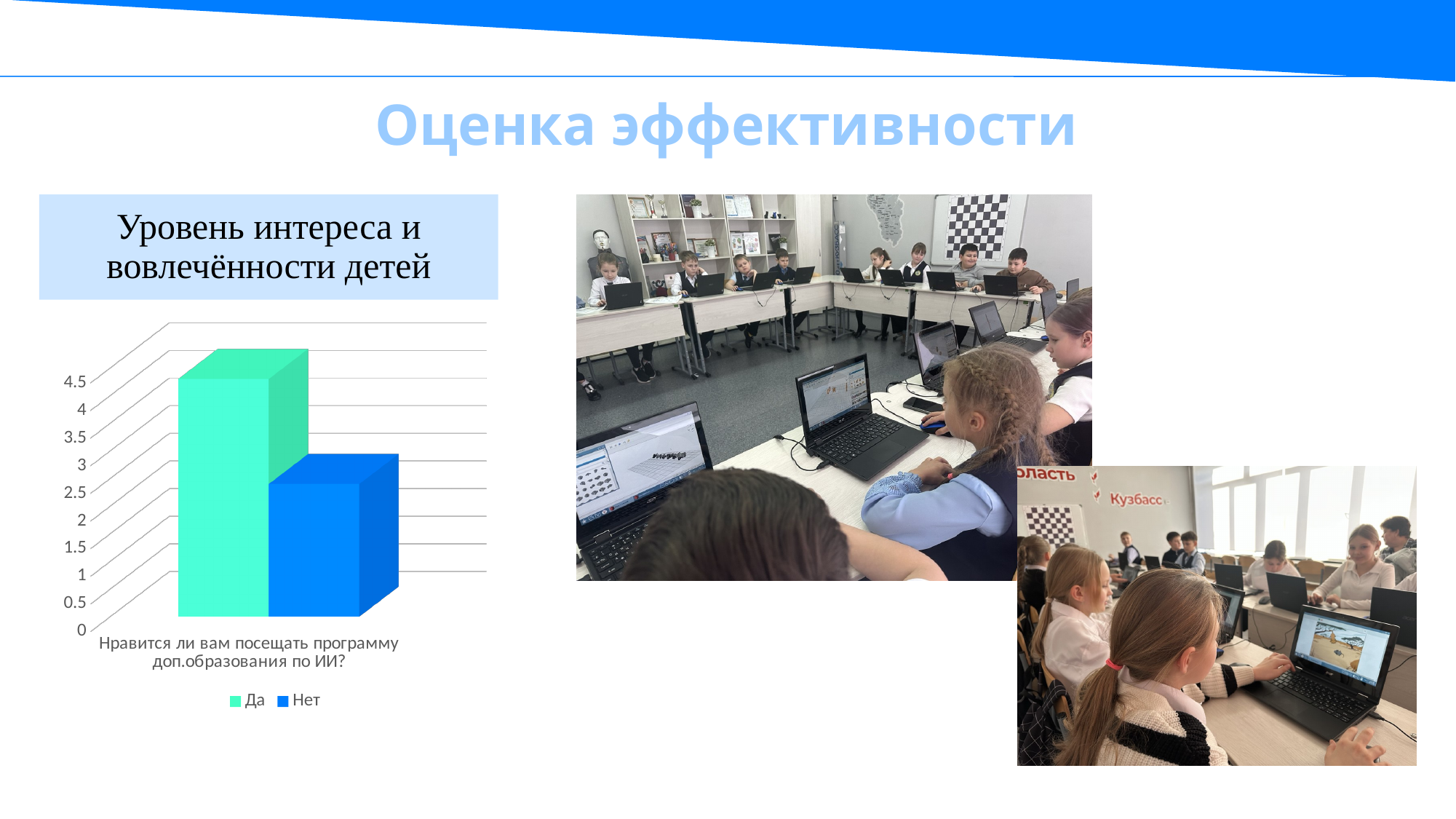
What is the title of the chart on the slide? Уровень интереса и вовлечённости детей What is the highest tick value shown on the vertical axis of the chart? 4.5 Is the value for Нет greater or less than 2? greater Is the value for Нет greater or less than 3? less What are the series names listed in the chart legend? Да, Нет How many categories are shown on the x axis of the chart? 1 Which series has the lowest bar in the chart? Нет How many series does the chart legend list? 2 Is the value for Да greater or less than 3? greater What kind of chart is shown on the slide? bar chart Which series has the higher bar in the chart, Да or Нет? Да